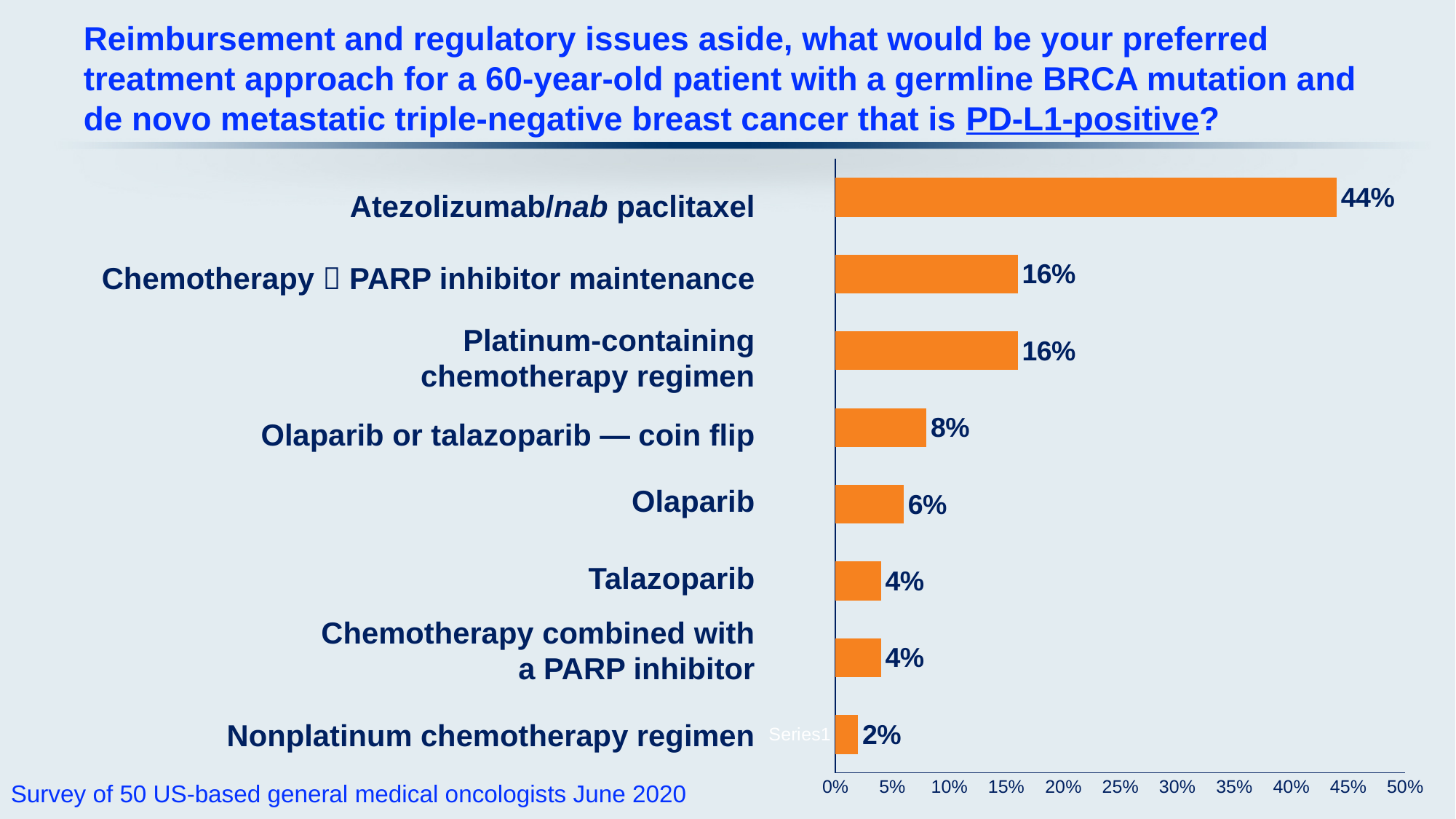
Which treatment approach has the lowest percentage? Nonplatinum chemotherapy regimen What kind of chart is shown on the slide? Bar chart Which treatment approach has the highest percentage? Atezolizumab/nab paclitaxel What is the value for Chemotherapy combined with a PARP inhibitor? 4% What percentage of respondents chose Atezolizumab/nab paclitaxel? 44% How many treatment approaches are shown in the chart? 8 Which is larger, the value for Olaparib or the value for Olaparib or talazoparib — coin flip? Olaparib or talazoparib — coin flip Is the value for Atezolizumab/nab paclitaxel greater or less than 40%? greater What percentage chose Nonplatinum chemotherapy regimen? 2% What is the value for Olaparib or talazoparib — coin flip? 8% What is the difference between the value for Atezolizumab/nab paclitaxel and the value for Platinum-containing chemotherapy regimen? 28% What is the difference between the value for Olaparib and the value for Talazoparib? 2%